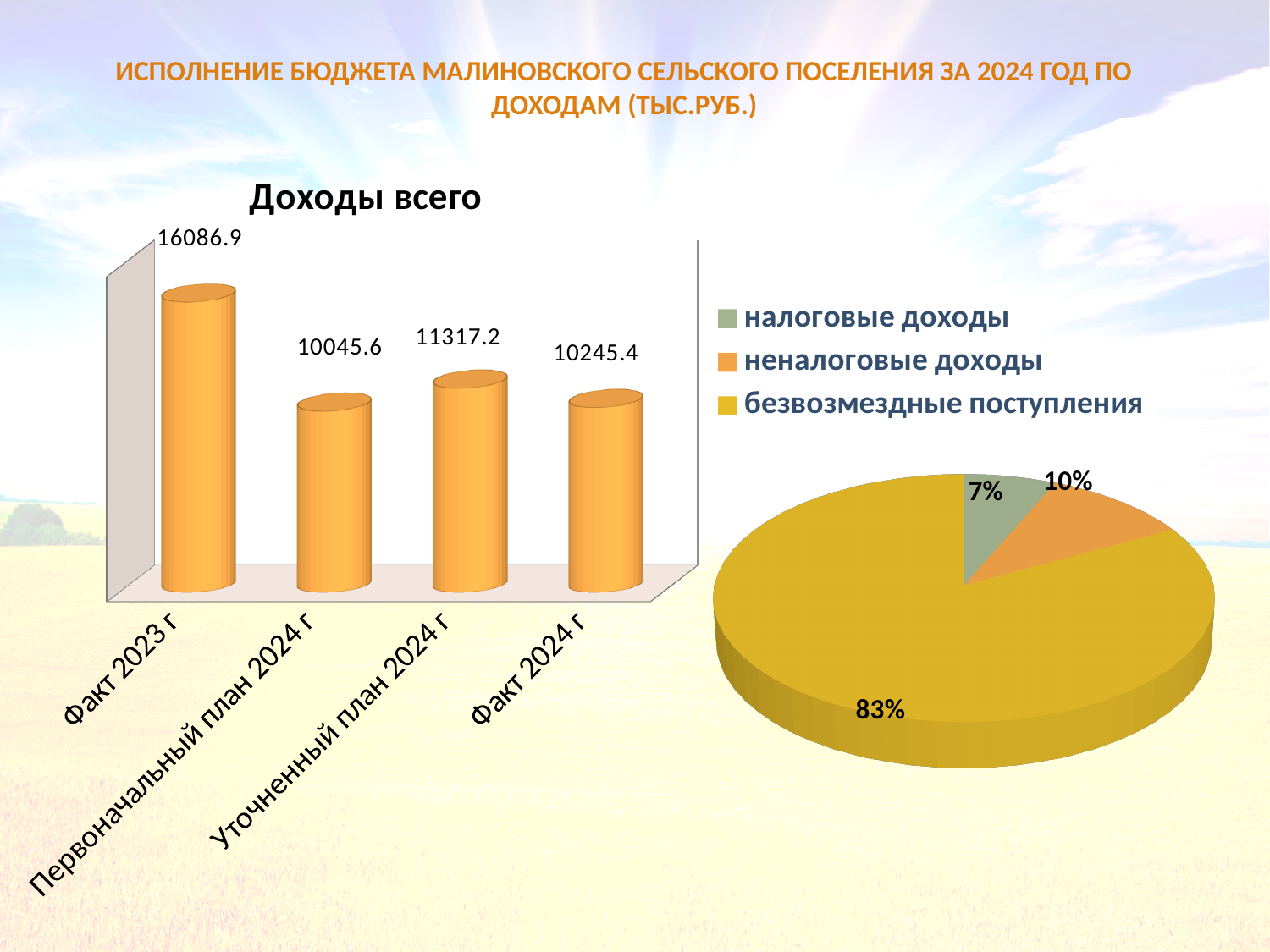
What type of chart is the chart on the right side of the slide? Pie chart How many categories are shown in the bar chart "Доходы всего"? 4 In the bar chart "Доходы всего", what is the value for Уточненный план 2024 г? 11317.2 In the bar chart "Доходы всего", what is the value for Факт 2024 г? 10245.4 In the pie chart on the right, what share do налоговые доходы have? 7% In the bar chart "Доходы всего", what is the value for Факт 2023 г? 16086.9 In the bar chart "Доходы всего", what is the difference between Факт 2023 г and Факт 2024 г? 5841.5 In the bar chart "Доходы всего", which category has the highest value? Факт 2023 г In the bar chart "Доходы всего", which category has the lowest value? Первоначальный план 2024 г In the bar chart "Доходы всего", what is the difference between Уточненный план 2024 г and Первоначальный план 2024 г? 1271.6 In the pie chart on the right, what share do безвозмездные поступления have? 83% In the bar chart "Доходы всего", which is larger: Уточненный план 2024 г or Факт 2024 г? Уточненный план 2024 г